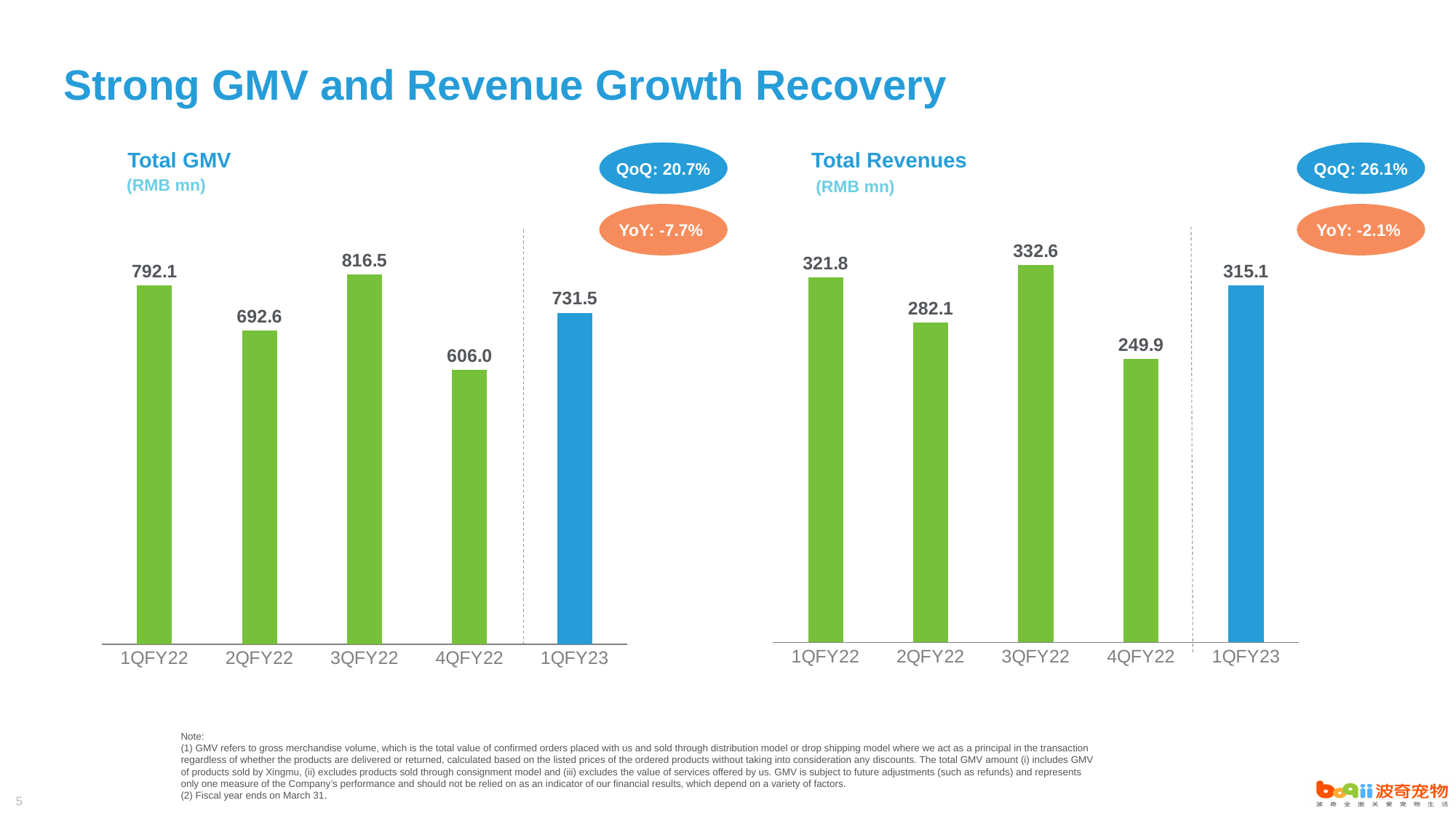
In the Total Revenues chart, what is the difference between 3QFY22 and 2QFY22? 50.5 In the Total Revenues chart, which is larger, the value for 1QFY22 or the value for 1QFY23? 1QFY22 In the Total GMV chart, which is larger, 2QFY22 or 1QFY23? 1QFY23 In the Total Revenues chart, what QoQ growth is shown in the blue bubble? QoQ: 26.1% In the Total GMV chart, what unit is stated under the chart title? RMB mn How many quarters are shown in the Total GMV chart? 5 What type of chart is the Total Revenues chart? Bar chart In the Total Revenues chart, what is the value for 4QFY22? 249.9 In the Total GMV chart, what is the difference between the 1QFY23 value and the 4QFY22 value? 125.5 In the Total GMV chart, which quarter has the highest value? 3QFY22 In the Total GMV chart, what is the value for 1QFY23? 731.5 In the Total Revenues chart, which quarter has the lowest value? 4QFY22